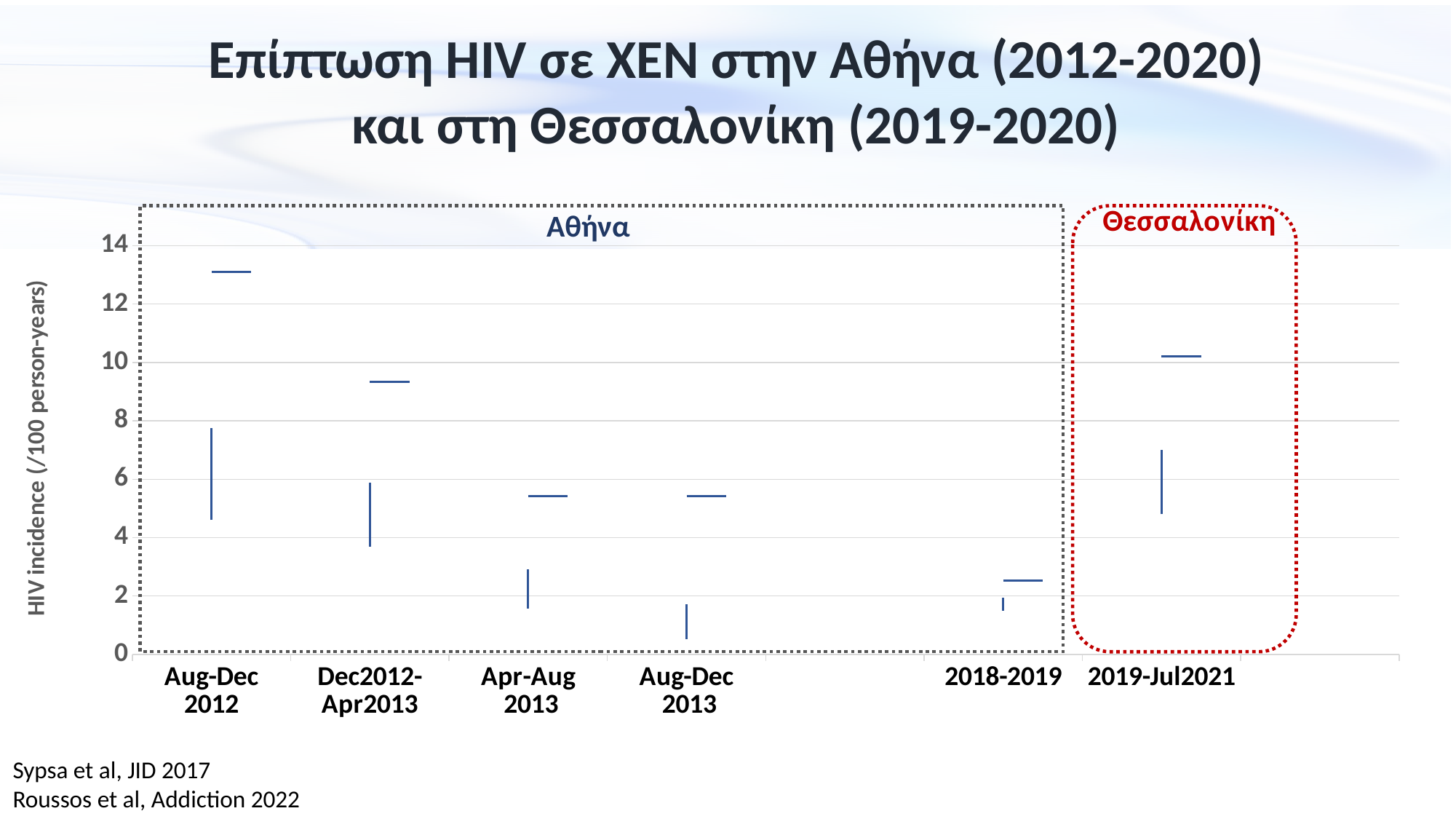
Which has the higher horizontal marker, Aug-Dec 2012 or 2019-Jul2021? Aug-Dec 2012 Is the horizontal marker for Apr-Aug 2013 greater or less than 6? less Is the horizontal marker for Dec2012-Apr2013 greater or less than 8? greater Which time period is enclosed in the red dotted box labelled Θεσσαλονίκη? 2019-Jul2021 Which time period has the highest horizontal marker on the chart? Aug-Dec 2012 Is the horizontal marker for 2019-Jul2021 greater or less than 8? greater Do the horizontal markers for the Athens periods rise or fall from Aug-Dec 2012 to 2018-2019? fall What is the label of the y axis of the chart? HIV incidence (/100 person-years) How many time-period categories are shown on the x axis of the chart? 6 Which time period has the lowest horizontal marker on the chart? 2018-2019